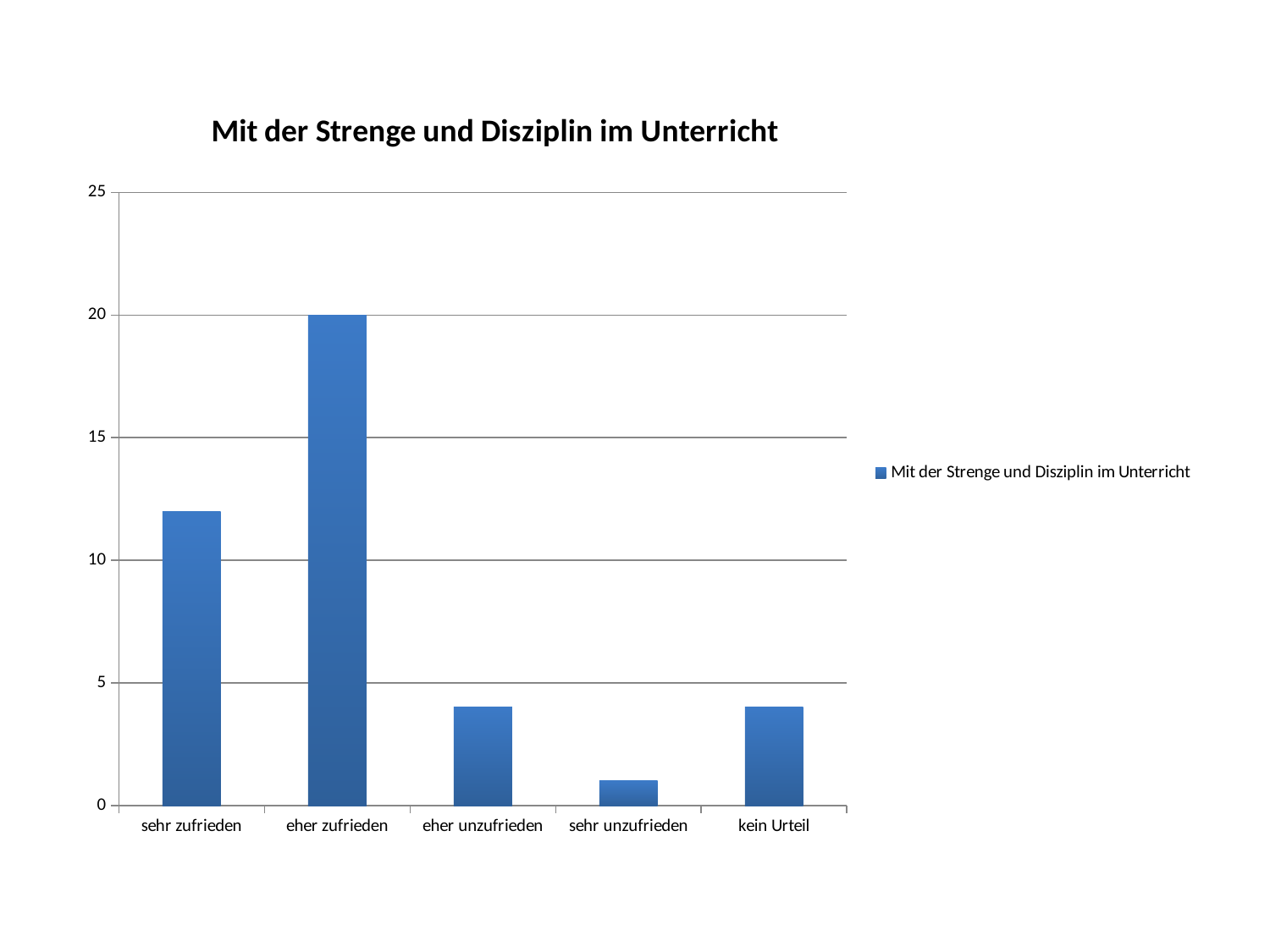
Which is larger, the value for "sehr zufrieden" or the value for "eher unzufrieden"? sehr zufrieden How many categories are shown on the x axis? 5 Is the value for "sehr zufrieden" greater or less than 15? less Which category has the lowest value? sehr unzufrieden Which is larger, the value for "eher zufrieden" or the value for "sehr zufrieden"? eher zufrieden Is the value for "sehr zufrieden" greater or less than 10? greater What is the value for "eher zufrieden"? 20 Is the value for "eher unzufrieden" greater or less than 5? less Which category has the highest value? eher zufrieden How many series does the legend list? 1 What kind of chart is shown on the slide? bar chart